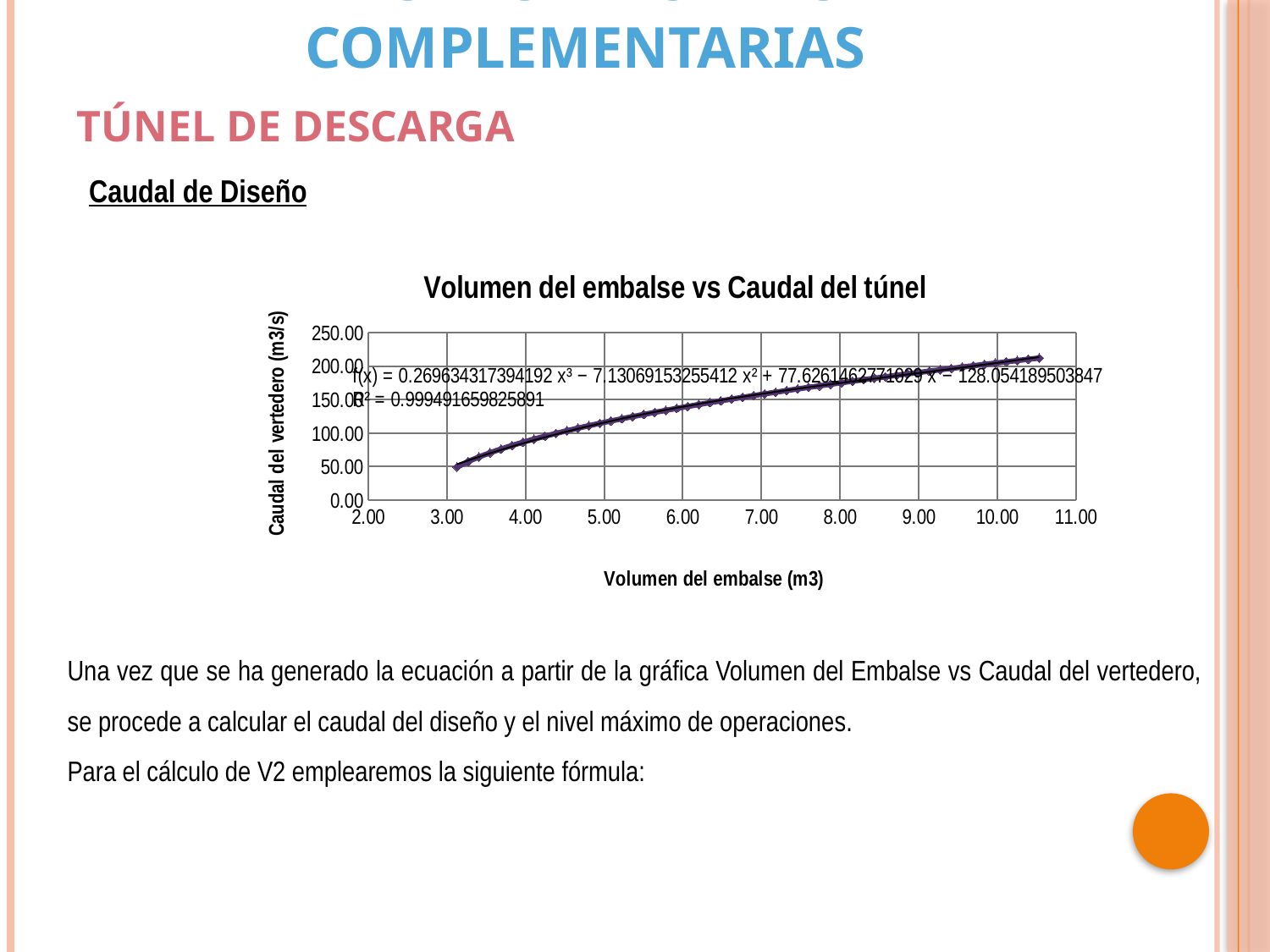
What is the highest tick value shown on the x axis? 11.00 What R² value is printed on the chart for the trendline? 0.999491659825891 Is the value of Caudal del vertedero at the lowest plotted Volumen del embalse (around 3.00) greater or less than 100.00? less What is the title of the chart? Volumen del embalse vs Caudal del túnel Is the value of Caudal del vertedero at a Volumen del embalse of 10.00 greater or less than 150.00? greater What is the highest tick value shown on the y axis? 250.00 Do the values rise or fall as the volume of the reservoir increases along the x axis? rise Is the value of Caudal del vertedero at a Volumen del embalse of 7.00 greater or less than 100.00? greater What kind of chart is shown on the slide? scatter chart What is the label of the y axis? Caudal del vertedero (m3/s)